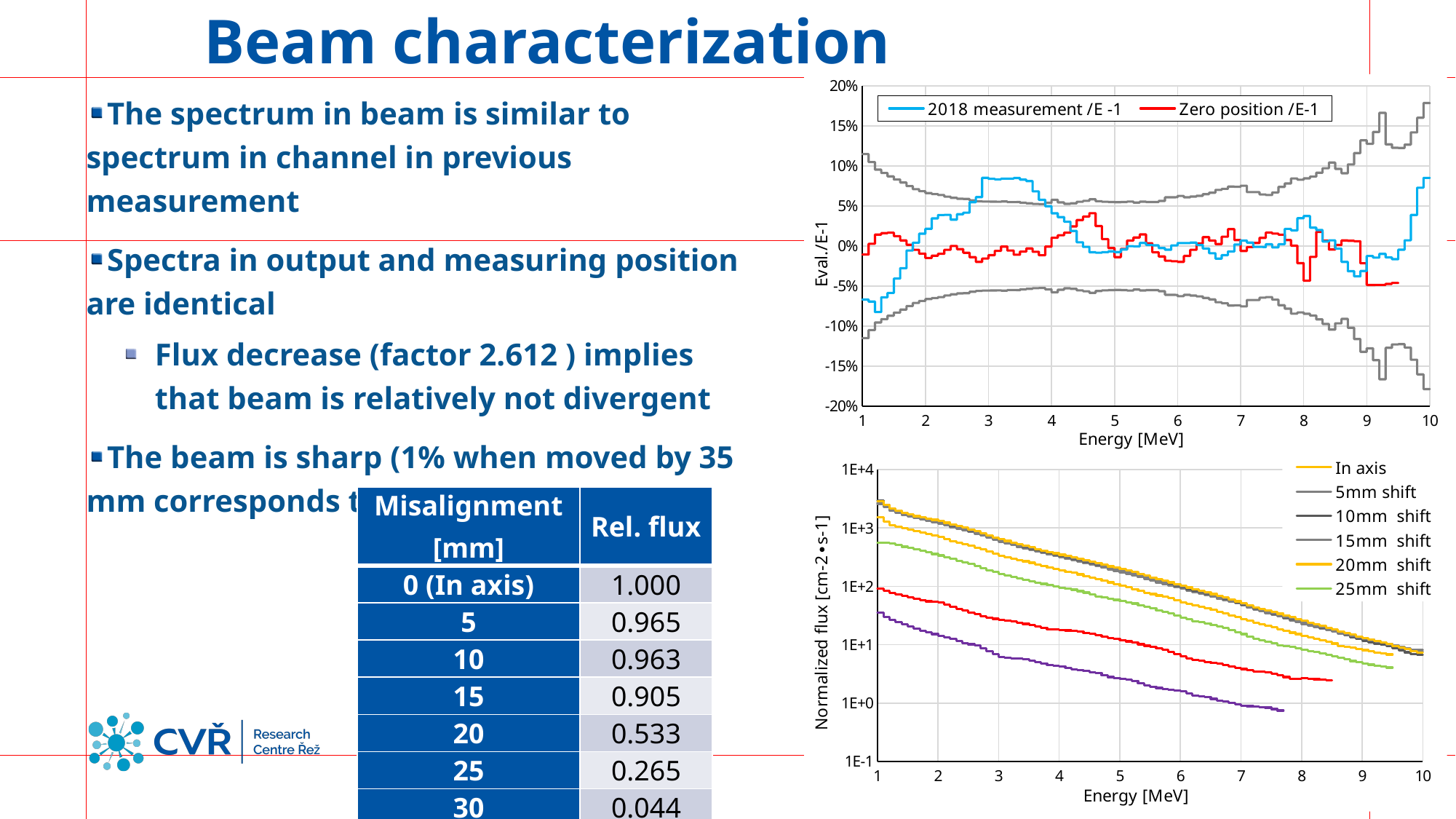
In the bottom chart, which series is higher at 5 MeV: In axis or 25mm shift? In axis What kind of chart is the top chart (Eval./E-1 versus Energy)? line chart What is the y-axis title of the bottom chart? Normalized flux [cm-2•s-1] How many series does the legend of the top chart list? 2 In the top chart, is the value of the 2018 measurement /E -1 series at 3 MeV greater or less than 5%? greater In the bottom chart, do the values of the In axis series rise or fall as energy increases from 1 to 10 MeV? fall How many series does the legend of the bottom chart list? 6 What kind of chart is the bottom chart (Normalized flux versus Energy)? line chart In the top chart, is the value of the 2018 measurement /E -1 series at 1 MeV greater or less than -5%? less In the bottom chart, is the value of the 25mm shift series at 1 MeV greater or less than 1E+2? greater What is the x-axis title of the bottom chart? Energy [MeV]